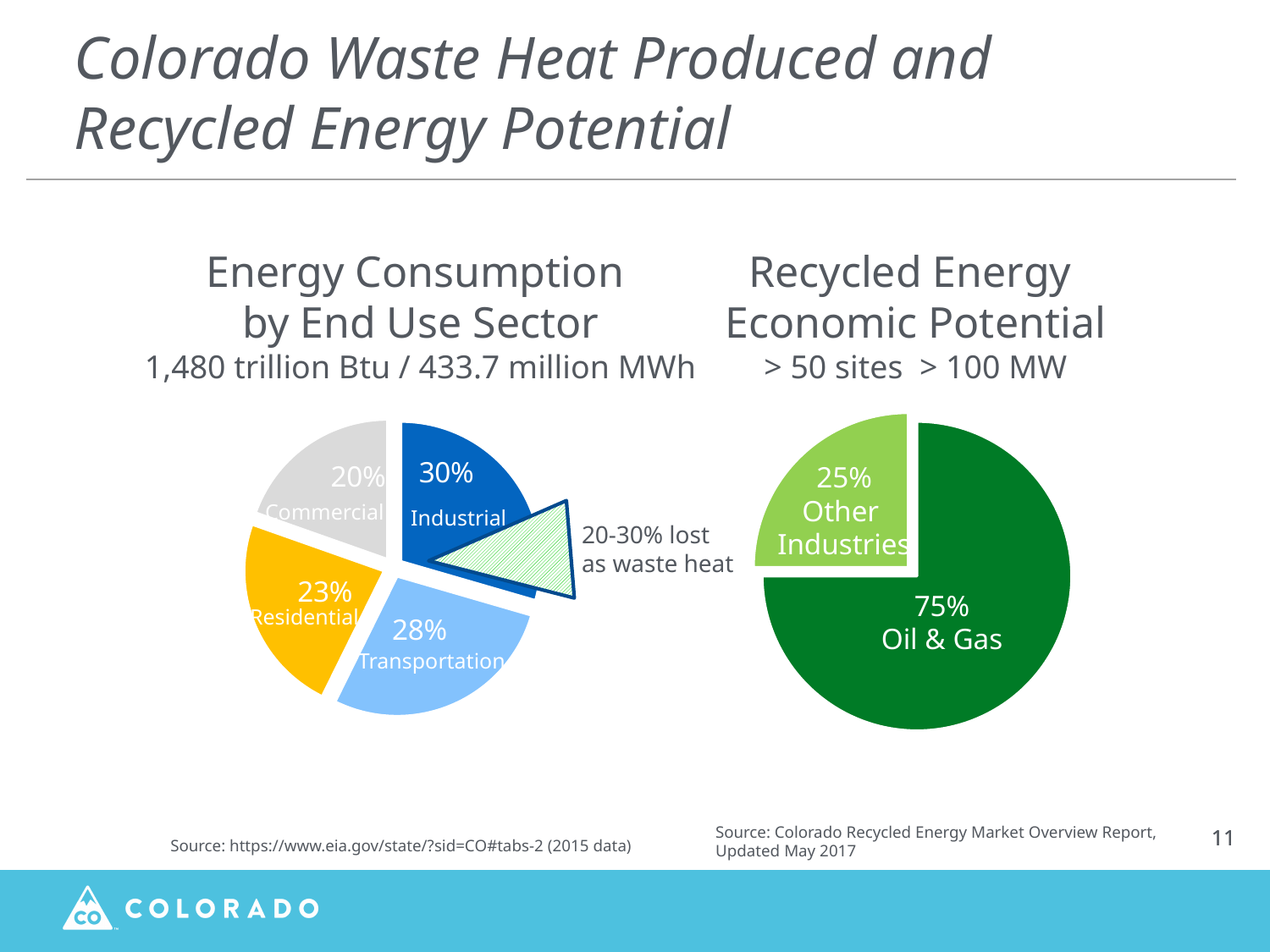
In the Energy Consumption by End Use Sector chart, what share does Industrial have? 30% In the Recycled Energy Economic Potential chart, what share does Oil & Gas have? 75% In the Recycled Energy Economic Potential chart, what share do Other Industries have? 25% In the Energy Consumption by End Use Sector chart, which sector has the smallest share? Commercial In the Energy Consumption by End Use Sector chart, which sector has the largest share? Industrial In the Energy Consumption by End Use Sector chart, what is the difference between the Industrial and Commercial shares? 10% In the Energy Consumption by End Use Sector chart, what share does Residential have? 23% In the Energy Consumption by End Use Sector chart, what share does Transportation have? 28% What type of chart is the Recycled Energy Economic Potential chart? Pie chart In the Energy Consumption by End Use Sector chart, what share does Commercial have? 20% In the Energy Consumption by End Use Sector chart, how many sectors are shown? 4 In the Recycled Energy Economic Potential chart, which is larger, Oil & Gas or Other Industries? Oil & Gas